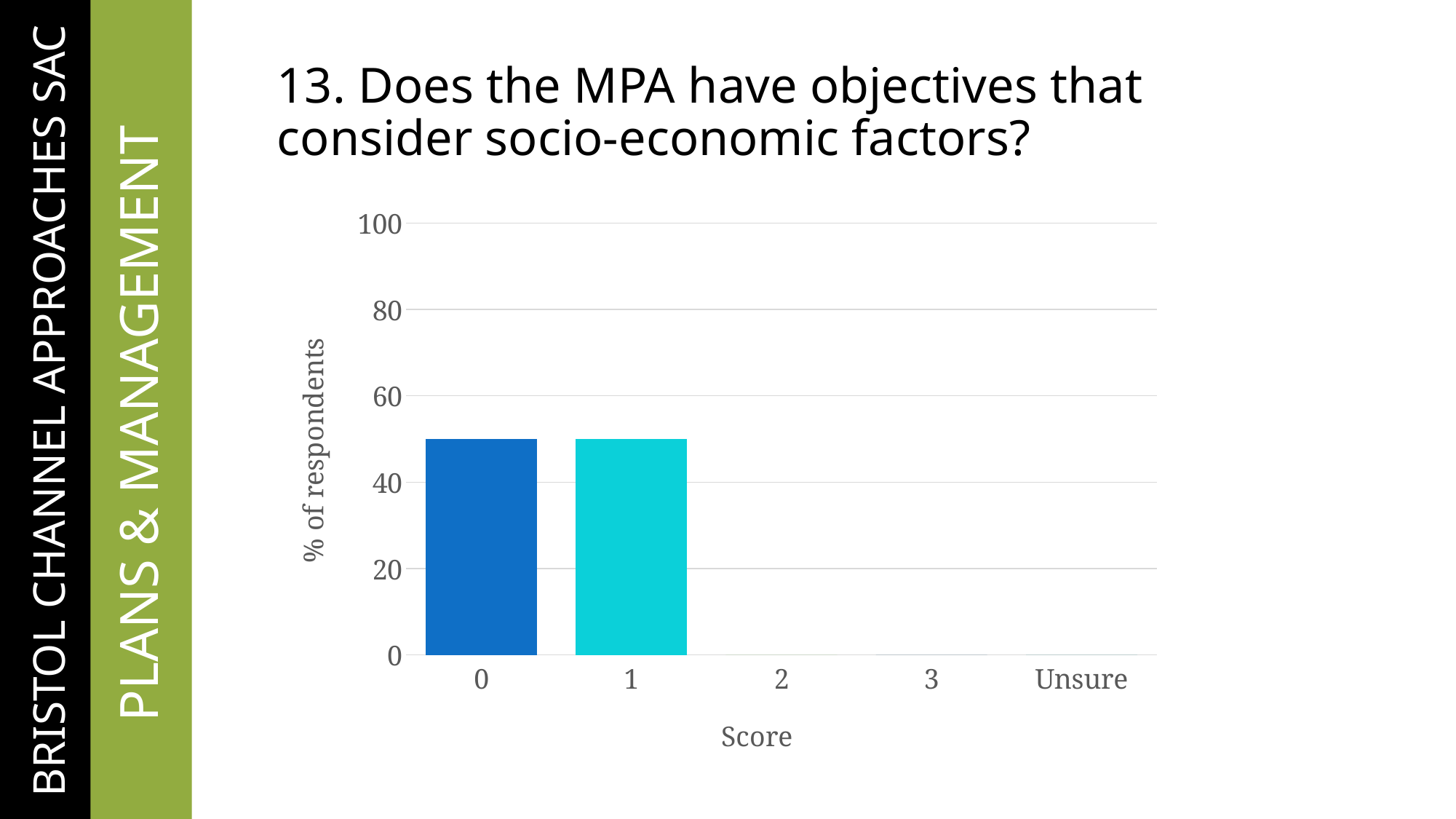
How many categories are shown on the x axis of the chart? 5 Is the value for Unsure greater or less than 20? less Is the value for score 0 greater or less than 40? greater How many categories have a visible bar in the chart? 2 What is the label of the x axis of the chart? Score What kind of chart is shown on the slide? bar chart Is the value for score 0 greater or less than 60? less What is the label of the y axis of the chart? % of respondents